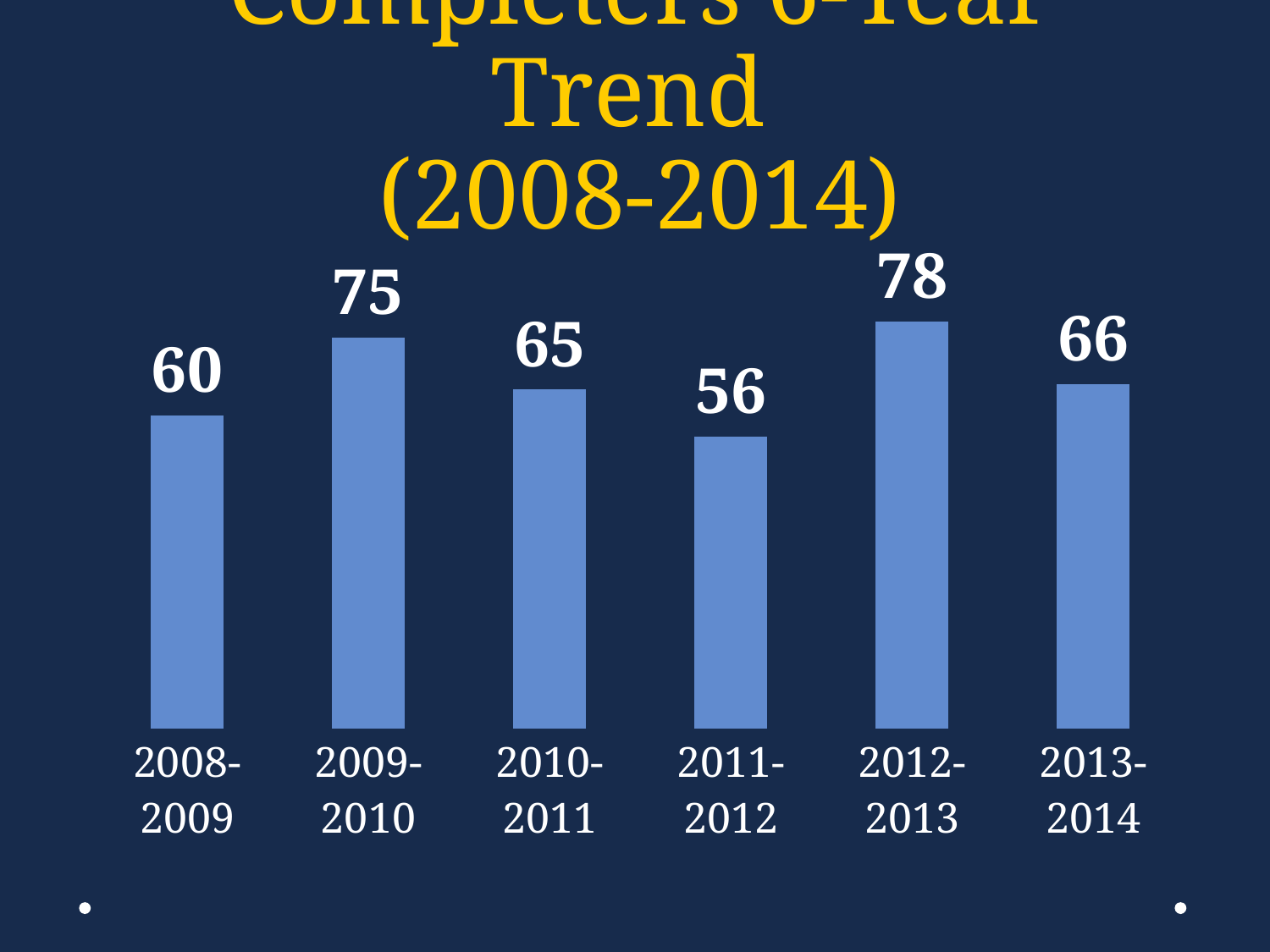
Does the value rise or fall from 2010-2011 to 2011-2012? Fall What is the value for 2008-2009? 60 What kind of chart is shown on the slide? Bar chart What is the difference between the values for 2009-2010 and 2008-2009? 15 What is the difference between the values for 2012-2013 and 2011-2012? 22 Which is larger, the value for 2010-2011 or the value for 2013-2014? 2013-2014 What is the value for 2011-2012? 56 What year range is given in parentheses in the chart title? 2008-2014 How many year categories are shown on the chart? 6 What is the value for 2013-2014? 66 Which year has the highest value? 2012-2013 Which year has the lowest value? 2011-2012